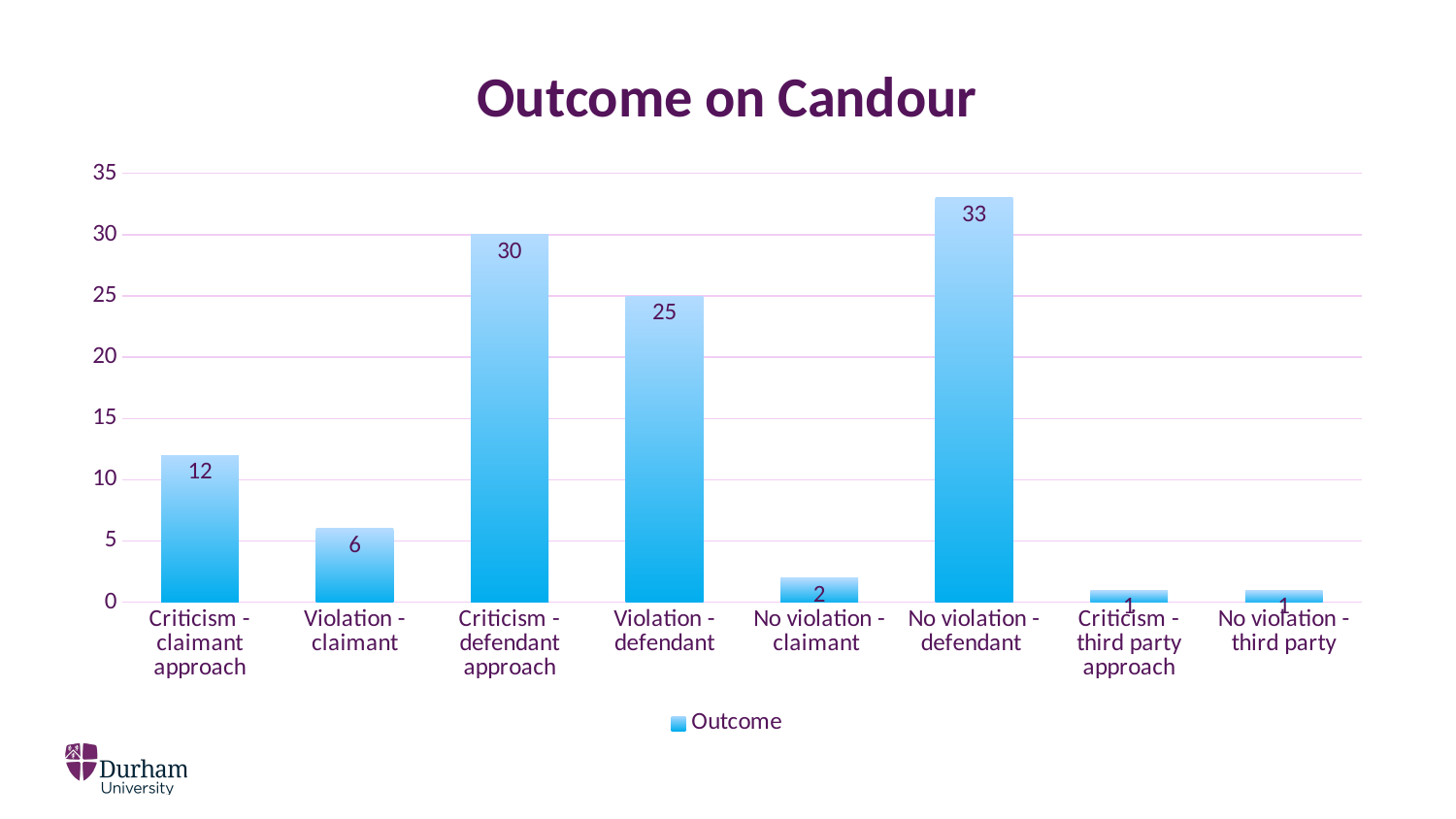
What is the title of the chart? Outcome on Candour What is the value for "Violation - defendant"? 25 What is the value for "Criticism - claimant approach"? 12 What kind of chart is shown? bar chart What is the name of the series in the legend? Outcome Which category has the highest value? No violation - defendant How many categories are shown on the x axis? 8 What is the difference between "Criticism - defendant approach" and "Violation - defendant"? 5 What is the value for "No violation - defendant"? 33 How many series does the legend list? 1 Which is larger, "Violation - claimant" or "No violation - claimant"? Violation - claimant Is the value for "Criticism - defendant approach" greater or less than 25? greater